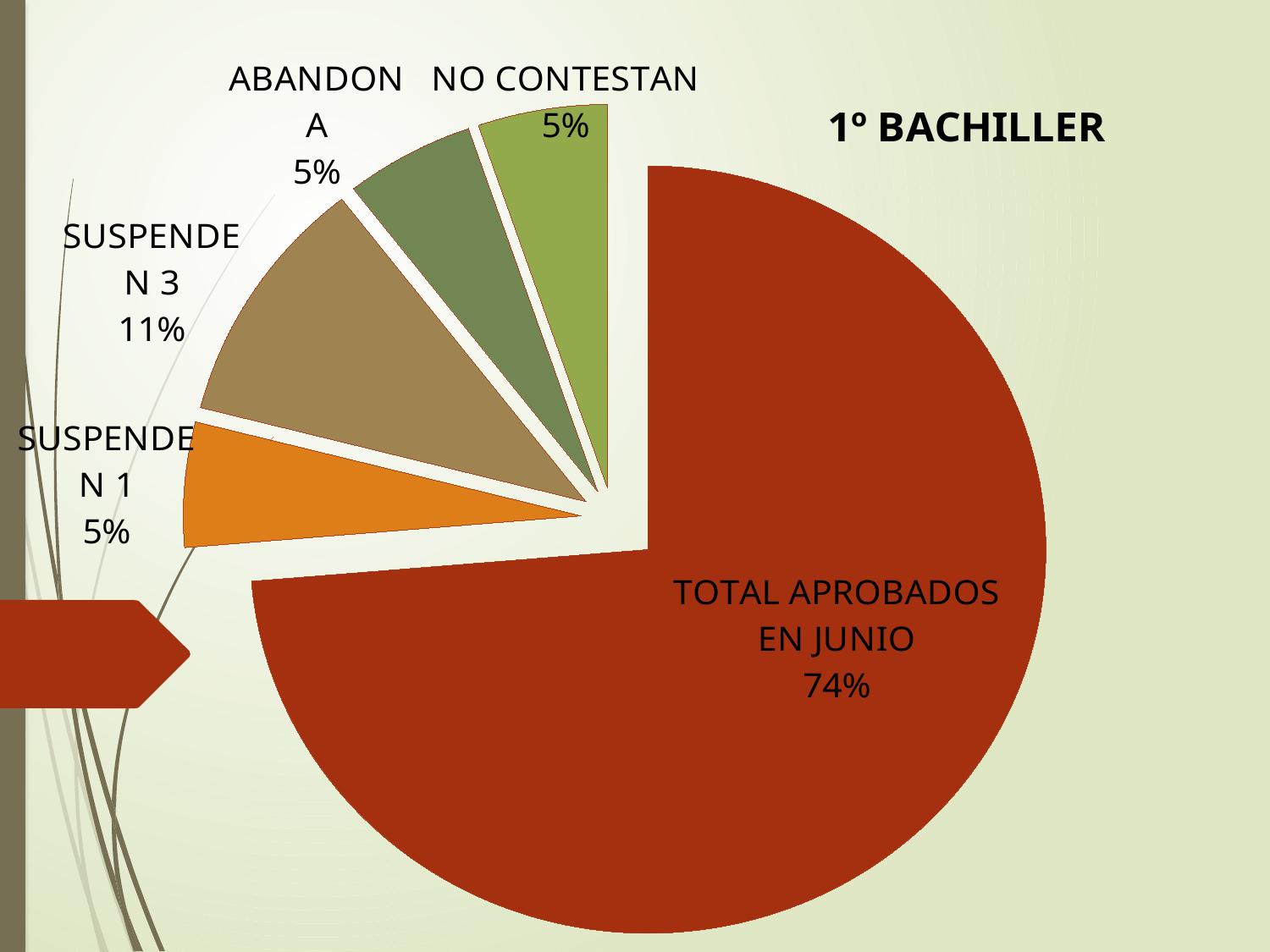
What colour is the TOTAL APROBADOS EN JUNIO slice? Dark red Which is larger, the SUSPENDEN 3 slice or the ABANDONA slice? SUSPENDEN 3 How many slices does the pie chart have? 5 What kind of chart is shown on the slide? Pie chart What percentage does the SUSPENDEN 1 slice show? 5% What percentage does the TOTAL APROBADOS EN JUNIO slice show? 74% What percentage does the SUSPENDEN 3 slice show? 11% Which slice of the pie is the largest? TOTAL APROBADOS EN JUNIO What percentage does the NO CONTESTAN slice show? 5% What percentage does the ABANDONA slice show? 5% What is the title of the chart? 1º BACHILLER What is the difference in percentage points between TOTAL APROBADOS EN JUNIO and SUSPENDEN 3? 63